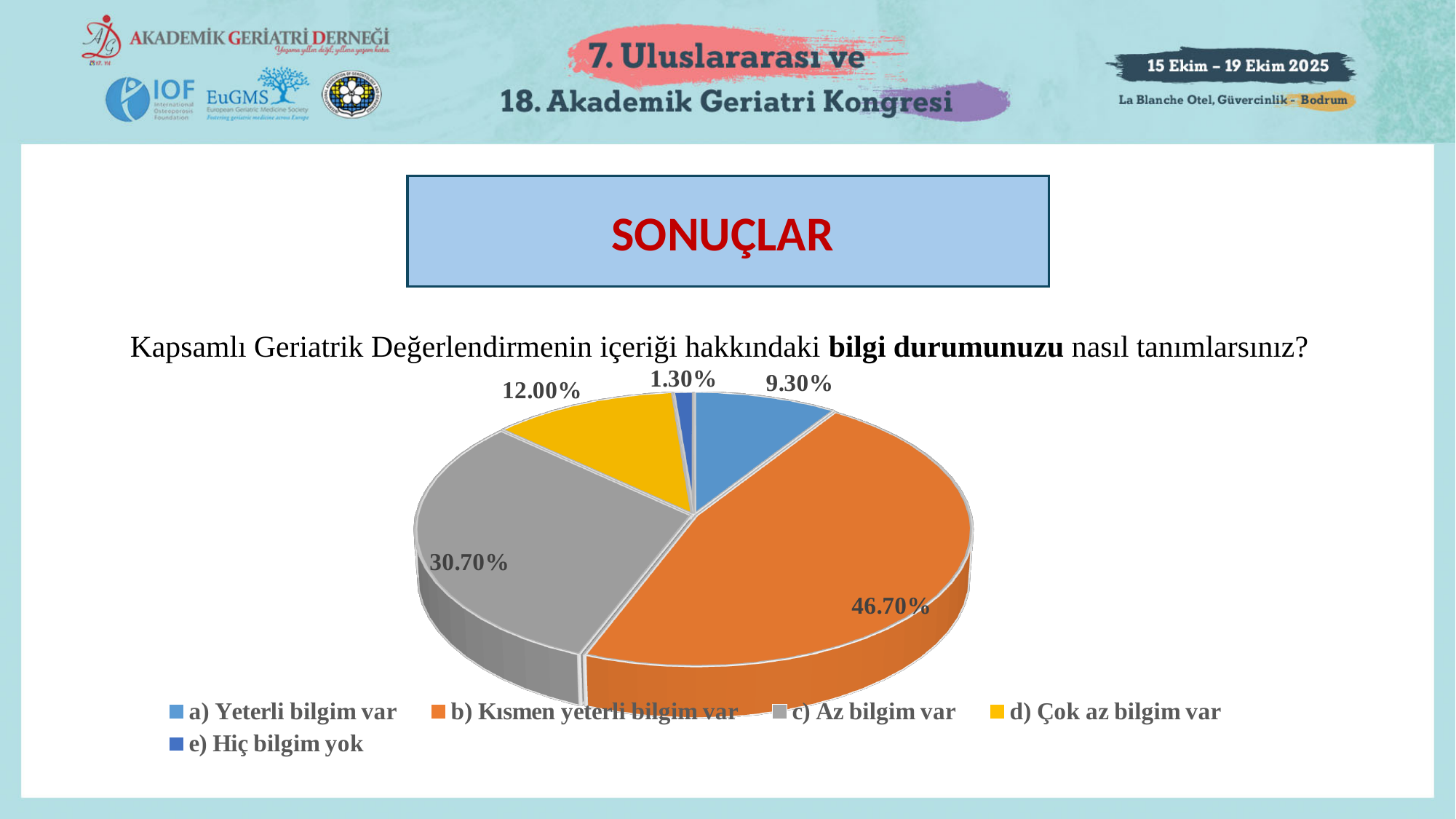
Which is larger: the share for "d) Çok az bilgim var" or the share for "a) Yeterli bilgim var"? d) Çok az bilgim var What is the difference in percentage points between "b) Kısmen yeterli bilgim var" and "c) Az bilgim var"? 16.00% What percentage of respondents answered "e) Hiç bilgim yok"? 1.30% What percentage of respondents answered "c) Az bilgim var"? 30.70% What percentage of respondents answered "a) Yeterli bilgim var"? 9.30% What colour is the slice for "d) Çok az bilgim var"? Yellow What type of chart is shown on the slide? Pie chart What is the combined share of "a) Yeterli bilgim var" and "e) Hiç bilgim yok"? 10.60% Which response category has the smallest share of the pie? e) Hiç bilgim yok Which response category has the largest share of the pie? b) Kısmen yeterli bilgim var What percentage of respondents answered "b) Kısmen yeterli bilgim var"? 46.70% How many response categories are shown in the pie chart? 5